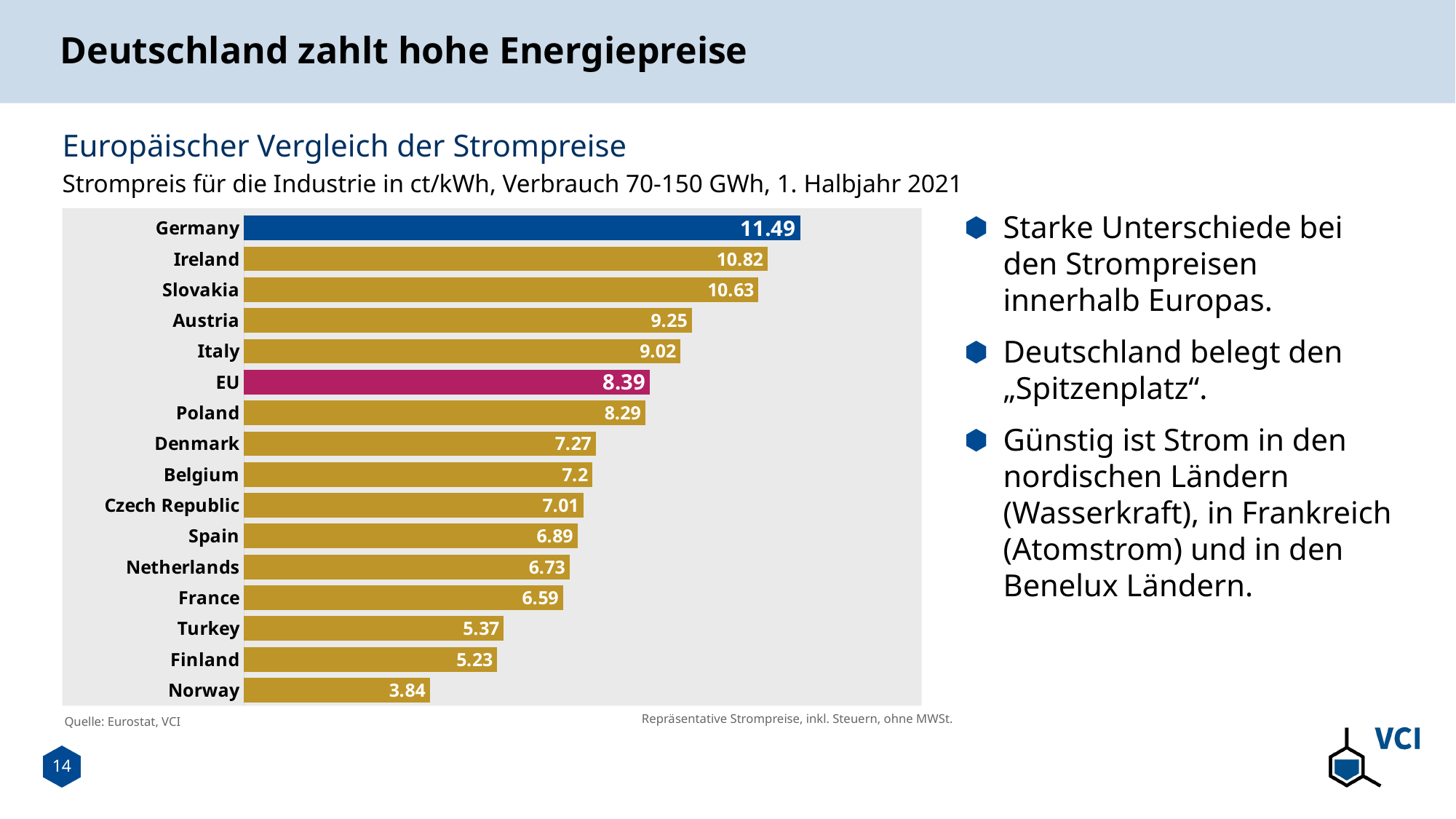
Which country has the highest electricity price in the chart? Germany What type of chart is shown on the slide? Bar chart What is the electricity price shown for Germany? 11.49 What is the title of the chart? Europäischer Vergleich der Strompreise Which has a higher electricity price, Austria or Italy? Austria What is the electricity price shown for France? 6.59 What is the difference between the values for Germany and the EU? 3.1 Which country has the lowest electricity price in the chart? Norway Which has a lower electricity price, Finland or Turkey? Finland What is the difference between the values for Ireland and Slovakia? 0.19 What is the value shown for the EU bar? 8.39 How many bars (countries plus EU) are shown in the chart? 16